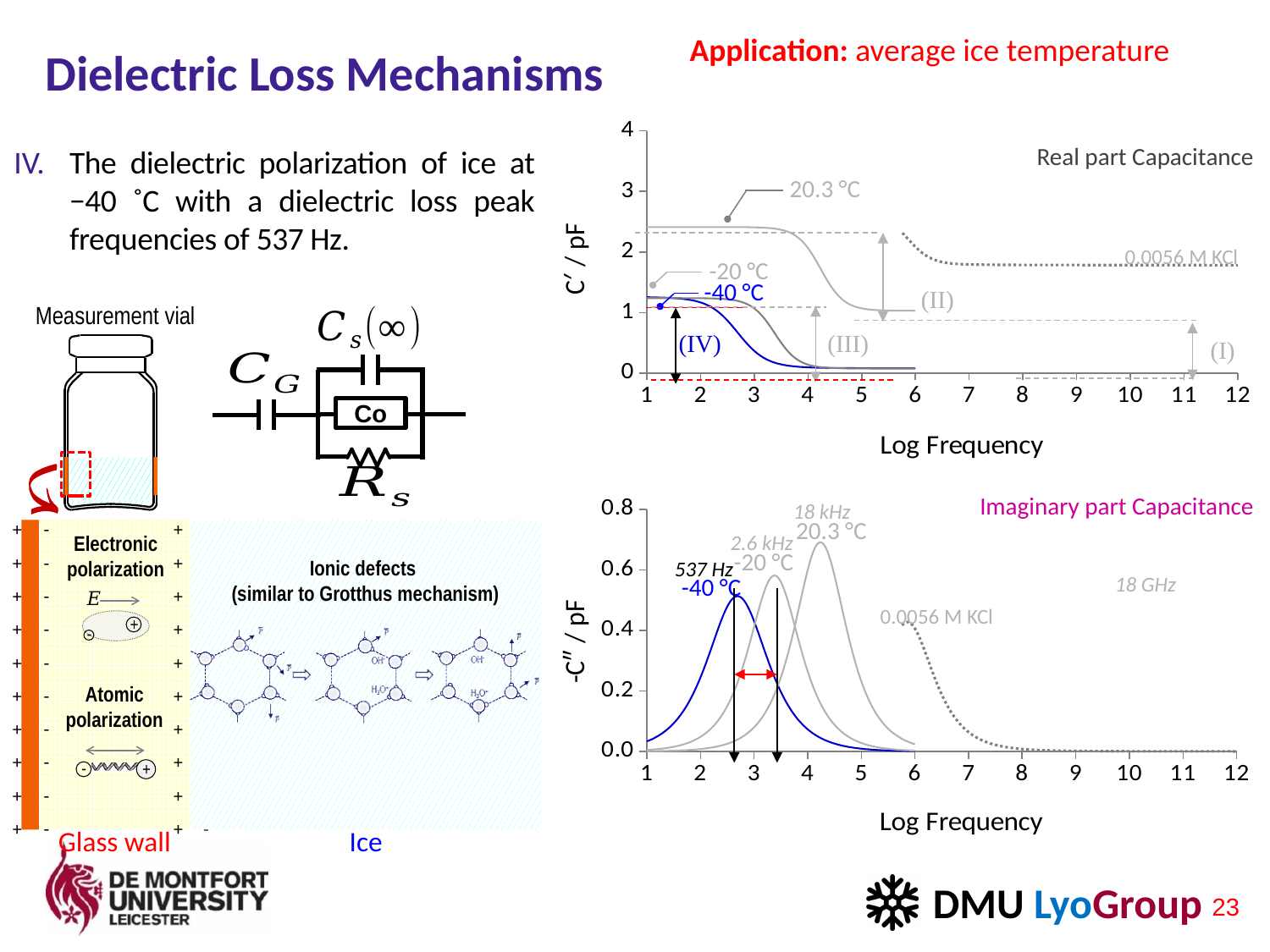
What is the x-axis label of the Real part Capacitance chart? Log Frequency In the Real part Capacitance chart, do the curves rise or fall as log frequency increases? fall In the Imaginary part Capacitance chart, what peak frequency is labelled for the -20 °C curve? 2.6 kHz In the Imaginary part Capacitance chart, what peak frequency is labelled for the 0.0056 M KCl curve? 18 GHz In the Imaginary part Capacitance chart, which curve has the highest peak? 20.3 °C In the Imaginary part Capacitance chart, what peak frequency is labelled for the 20.3 °C curve? 18 kHz In the Real part Capacitance chart, is the low-frequency value of the 20.3 °C curve greater or less than 2? greater In the Imaginary part Capacitance chart, is the peak value of the -40 °C curve greater or less than 0.6? less What kind of chart is the Real part Capacitance chart? line chart In the Imaginary part Capacitance chart, what peak frequency is labelled for the -40 °C curve? 537 Hz In the Imaginary part Capacitance chart, which curve peaks at the lowest log frequency? -40 °C How many curves are plotted in the Imaginary part Capacitance chart? 4